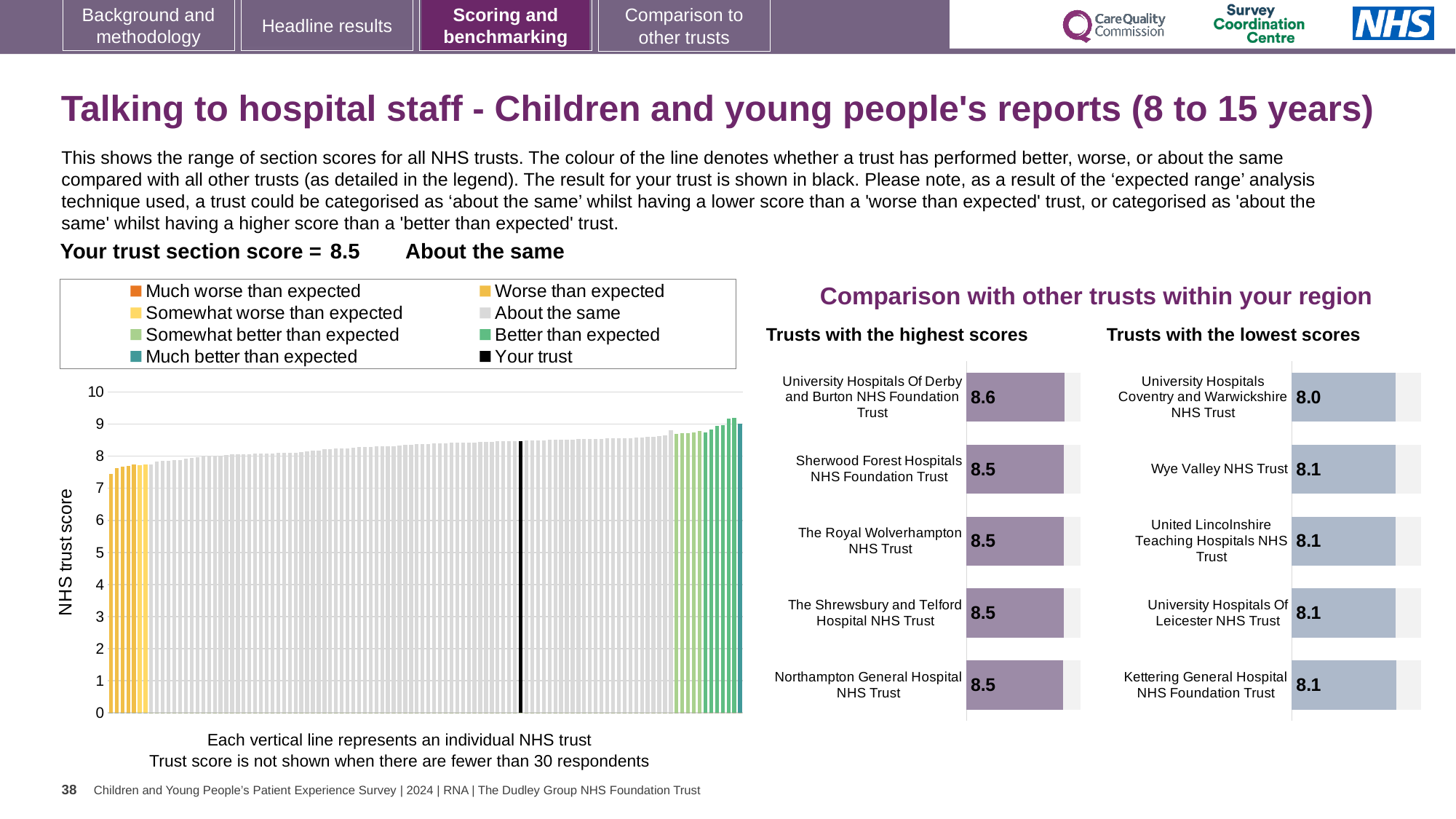
In the 'Trusts with the lowest scores' chart, what is the score for Northampton General Hospital NHS Trust's counterpart, United Lincolnshire Teaching Hospitals NHS Trust? 8.1 What kind of chart is the NHS trust score chart on the left? Bar chart In the 'Trusts with the lowest scores' chart, is the score for Kettering General Hospital NHS Foundation Trust larger than the score for University Hospitals Coventry and Warwickshire NHS Trust? Yes How many entries does the legend of the NHS trust score chart list? 8 How many trusts are listed in the 'Trusts with the highest scores' chart? 5 What is the difference between the score of University Hospitals Of Derby and Burton NHS Foundation Trust in the highest-scores chart and University Hospitals Coventry and Warwickshire NHS Trust in the lowest-scores chart? 0.6 In the NHS trust score chart, is the value of the lowest (leftmost) bar greater or less than 7? greater In the 'Trusts with the highest scores' chart, which trust has the highest score? University Hospitals Of Derby and Burton NHS Foundation Trust What is the section score for your trust shown on the NHS trust score chart? 8.5 In the 'Trusts with the lowest scores' chart, which trust has the lowest score? University Hospitals Coventry and Warwickshire NHS Trust In the 'Trusts with the highest scores' chart, what is the score for University Hospitals Of Derby and Burton NHS Foundation Trust? 8.6 In the 'Trusts with the lowest scores' chart, what is the score for Wye Valley NHS Trust? 8.1